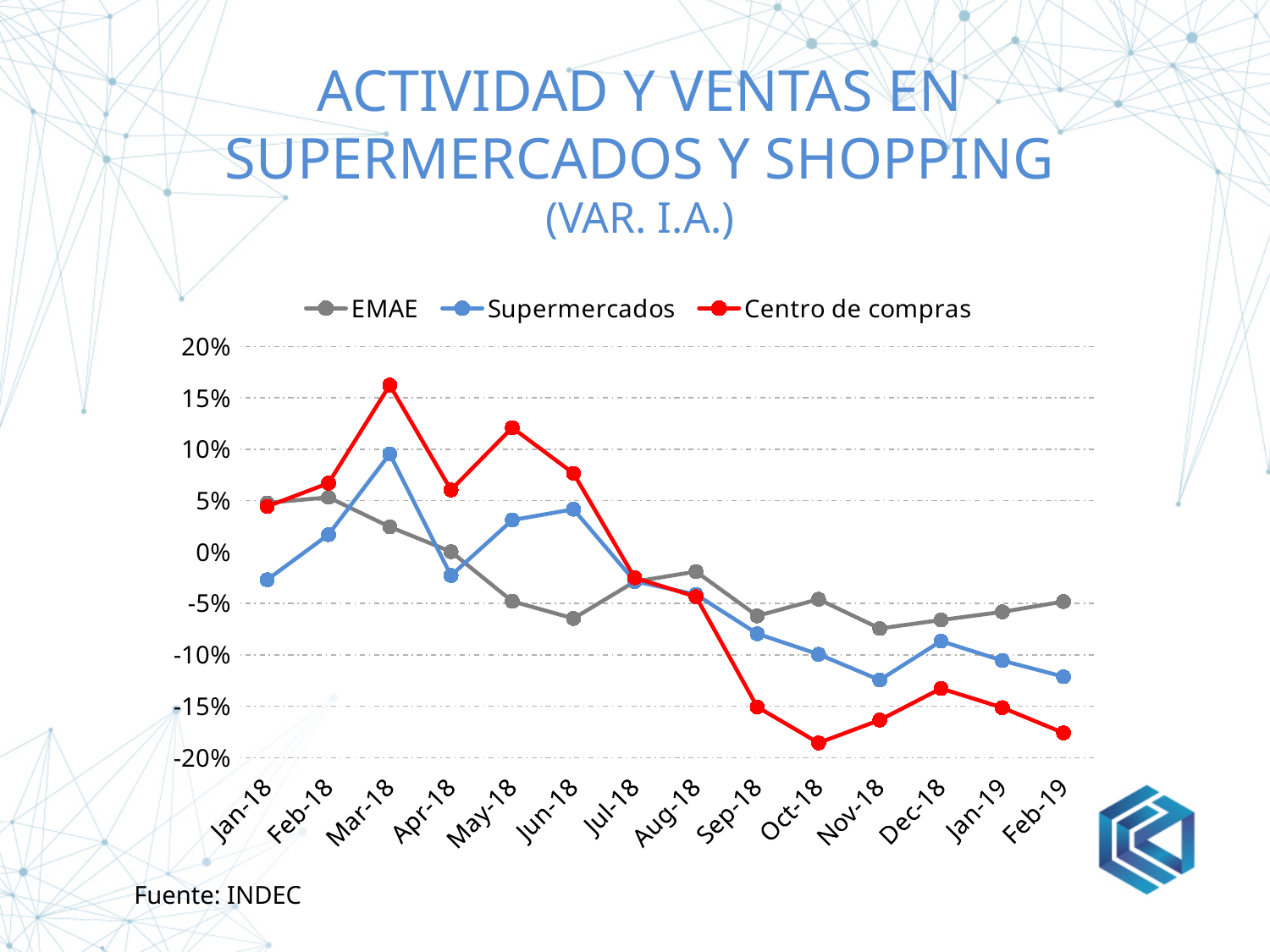
In which month does the Supermercados series reach its highest value? Mar-18 What colour is the Centro de compras line? Red Is the value for EMAE in Jun-18 greater or less than -5%? less Is the value for Centro de compras in Oct-18 greater or less than -15%? less Is the value for Centro de compras in Mar-18 greater or less than 15%? greater In Feb-19, which series has the higher value, EMAE or Centro de compras? EMAE Does the Centro de compras series rise or fall from Aug-18 to Oct-18? Fall In which month does the Centro de compras series reach its highest value? Mar-18 How many series does the legend list? 3 What kind of chart is shown on the slide? Line chart How many months are plotted along the x axis? 14